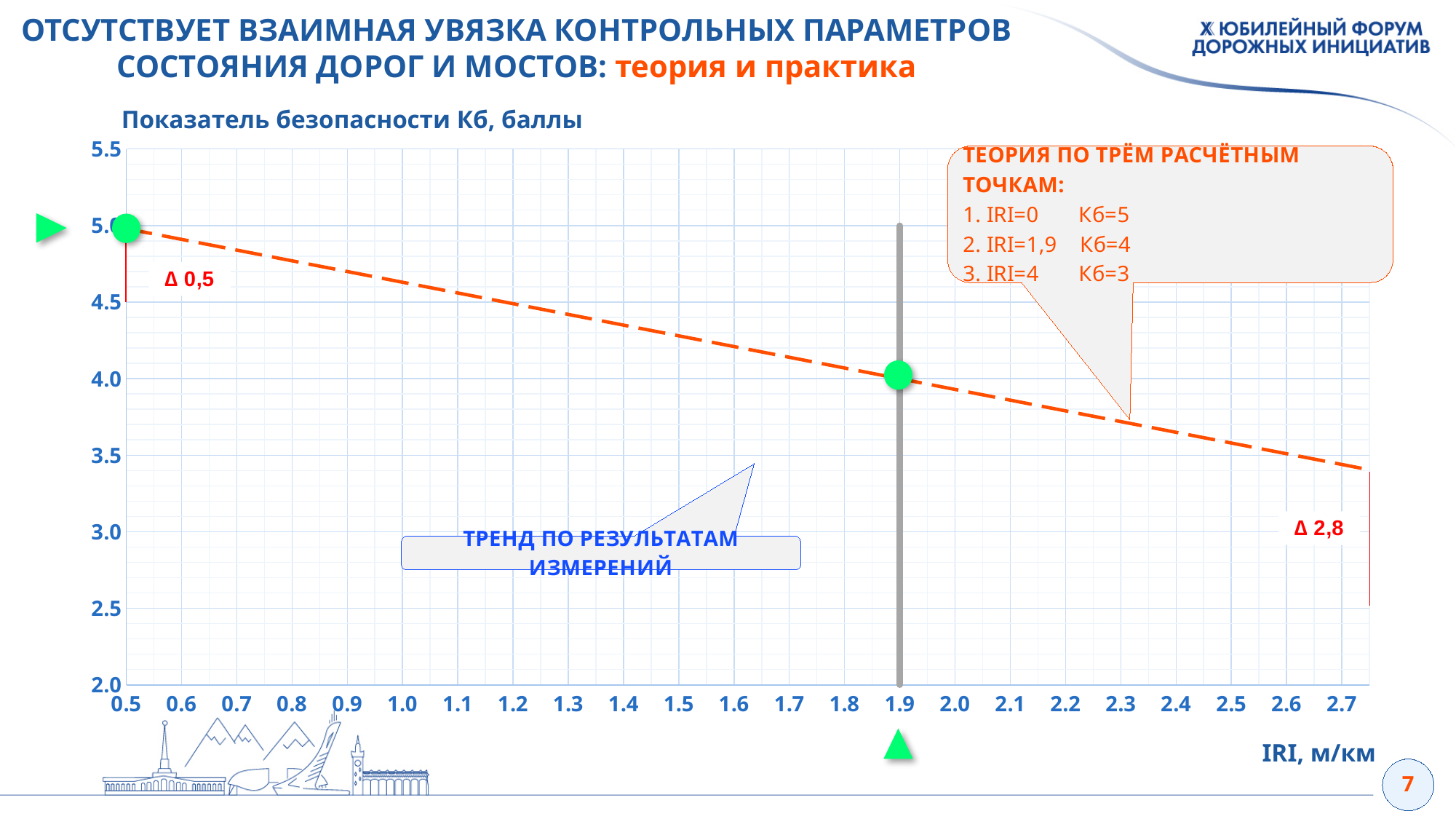
What is the Кб value of the green point at IRI = 1.9? 4.0 What is the highest value shown on the y axis? 5.5 Which of the two green points has the higher Кб value: the one at IRI = 0.5 or the one at IRI = 1.9? IRI = 0.5 How many green data points are marked on the trend line? 2 What kind of chart is shown on the slide? line chart What is the label of the x axis? IRI, м/км What is the Кб value of the green point at IRI = 0.5? 5.0 What is the lowest value shown on the x axis? 0.5 What is the label of the y axis? Показатель безопасности Кб, баллы Is the value of the trend line at IRI = 1.0 greater or less than 4.5? greater Does the dashed trend line rise or fall as IRI increases along the x axis? fall